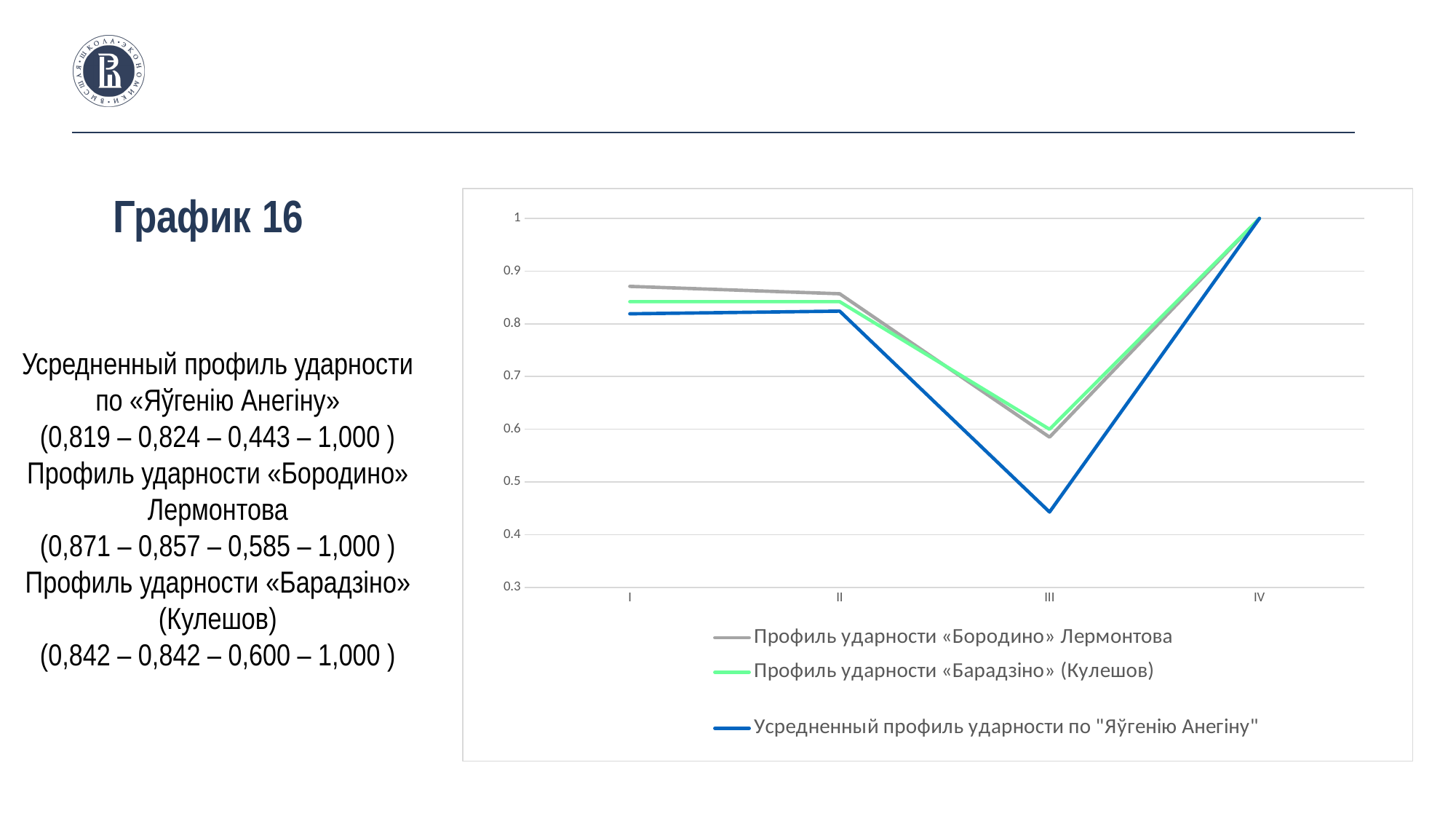
At which category does «Усредненный профиль ударности по «Яўгенію Анегіну»» reach its lowest value? III What is the value of «Усредненный профиль ударности по «Яўгенію Анегіну»» at category III? 0,443 What kind of chart is shown on the slide? line chart What is the value of «Профиль ударности «Бородино» Лермонтова» at category III? 0,585 How many categories are on the x axis? 4 At category I, which is larger: «Профиль ударности «Бородино» Лермонтова» or «Усредненный профиль ударности по «Яўгенію Анегіну»»? Профиль ударности «Бородино» Лермонтова What is the difference between «Профиль ударности «Бородино» Лермонтова» and «Усредненный профиль ударности по «Яўгенію Анегіну»» at category I? 0,052 What is the value of «Профиль ударности «Барадзіно» (Кулешов)» at category I? 0,842 Is the value of «Усредненный профиль ударности по «Яўгенію Анегіну»» at category III greater or less than 0.5? less What colour is the line for «Усредненный профиль ударности по «Яўгенію Анегіну»»? blue Do the values of all three series rise or fall from category II to category III? fall How many series does the legend list? 3